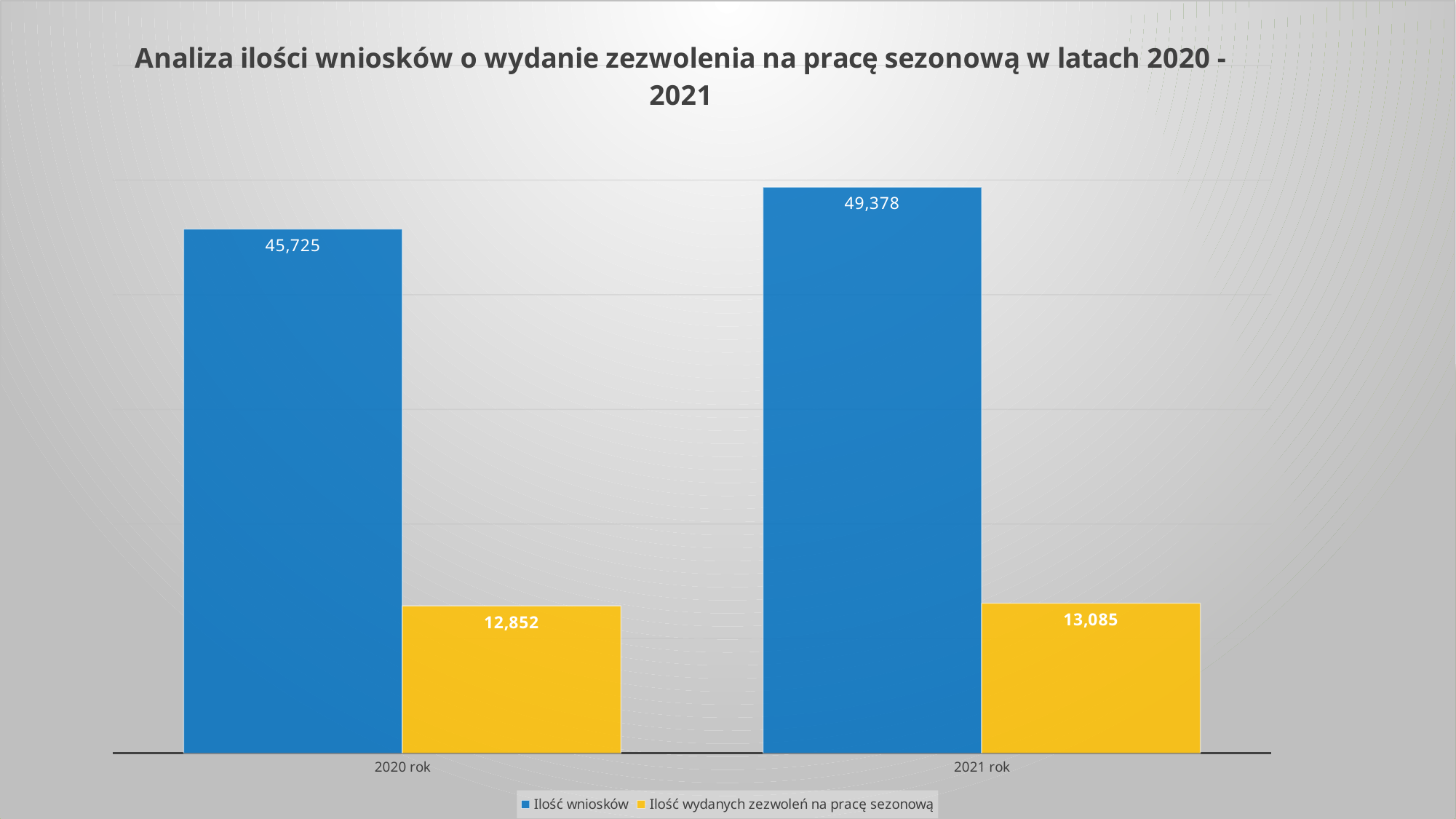
What kind of chart is shown on the slide? bar chart What is the difference between "Ilość wniosków" in 2021 rok and in 2020 rok? 3,653 What is the value of "Ilość wydanych zezwoleń na pracę sezonową" for 2021 rok? 13,085 Which year has the higher value for "Ilość wniosków"? 2021 rok What is the value of "Ilość wydanych zezwoleń na pracę sezonową" for 2020 rok? 12,852 Is "Ilość wydanych zezwoleń na pracę sezonową" for 2021 rok larger or smaller than for 2020 rok? larger What is the value of "Ilość wniosków" for 2020 rok? 45,725 Which year has the lower value for "Ilość wydanych zezwoleń na pracę sezonową"? 2020 rok What is the difference between "Ilość wniosków" and "Ilość wydanych zezwoleń na pracę sezonową" for 2020 rok? 32,873 How many categories are shown on the x axis? 2 What is the value of "Ilość wniosków" for 2021 rok? 49,378 How many series does the legend list? 2